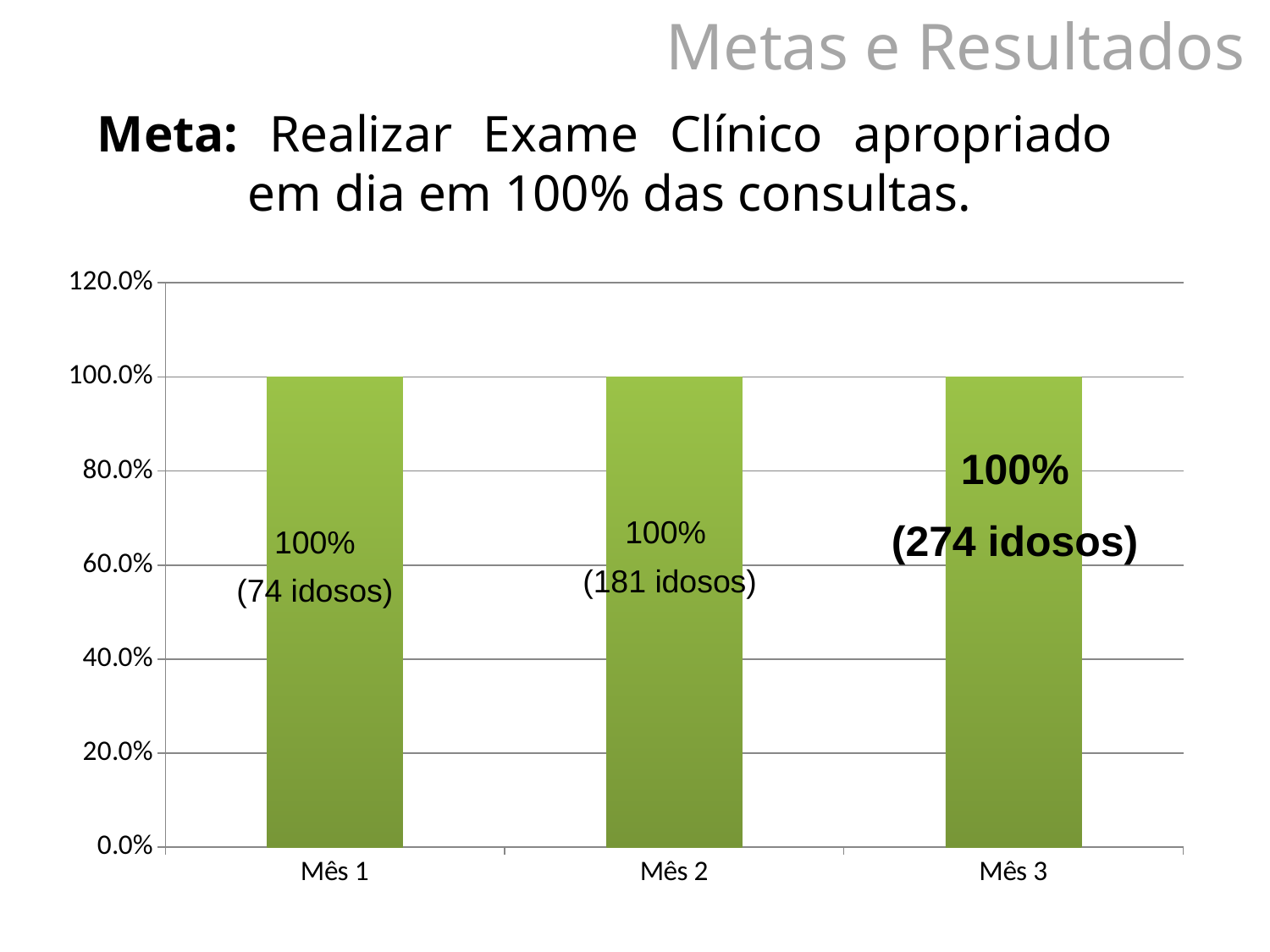
What is the highest value shown on the y axis? 120.0% What is the value for Mês 2? 100% What is the value for Mês 3? 100% How many idosos are indicated in the label for Mês 3? 274 idosos How many categories are shown on the x axis? 3 What is the difference between the percentage values for Mês 1 and Mês 3? 0% Is the value for Mês 2 greater or less than 80.0%? greater How many idosos are indicated in the label for Mês 1? 74 idosos Do the percentage values rise, fall or stay the same from Mês 1 to Mês 3? Stay the same What is the value for Mês 1? 100% What kind of chart is shown on the slide? Bar chart How many idosos are indicated in the label for Mês 2? 181 idosos